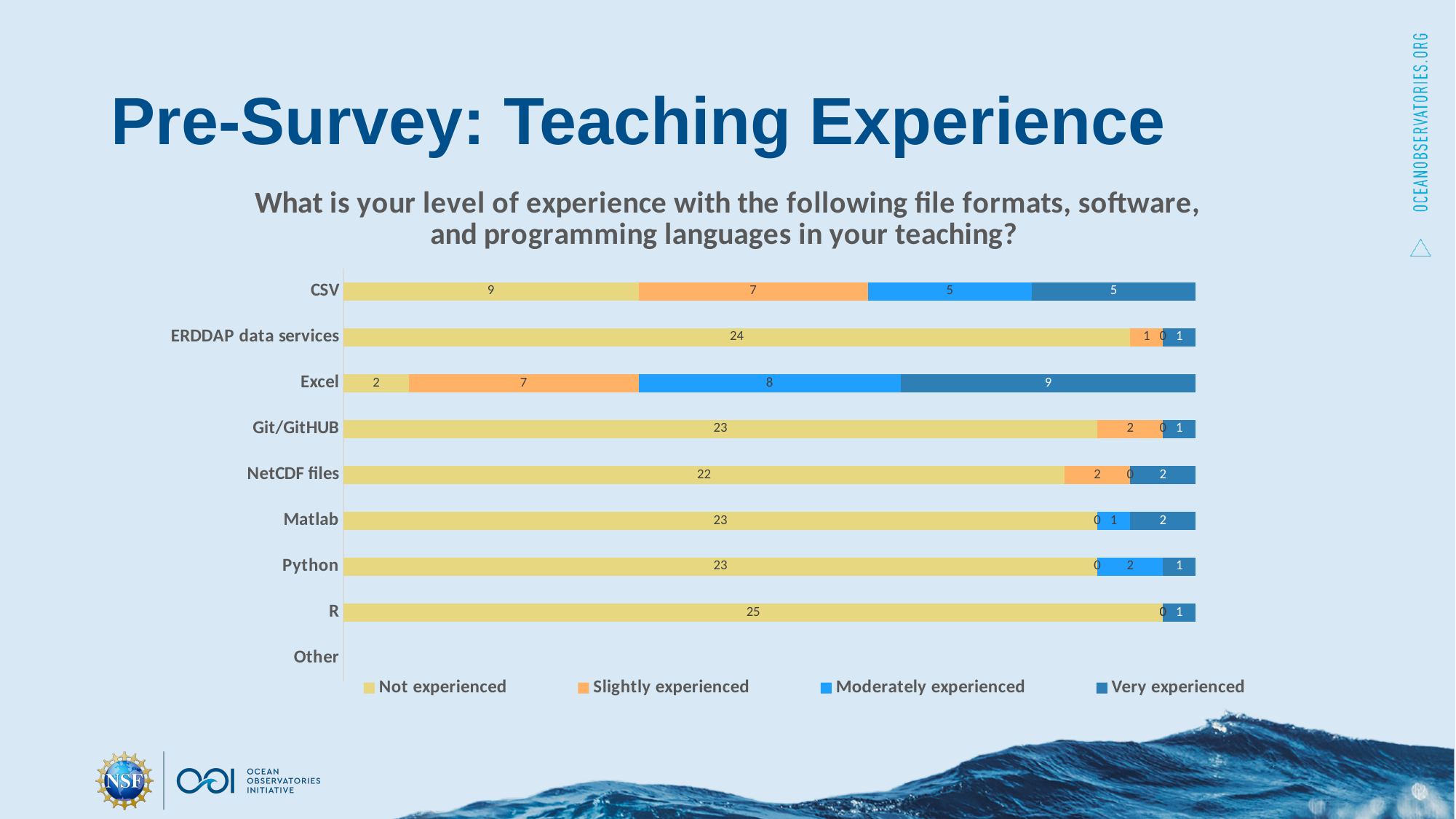
How many series does the legend list? 4 What type of chart is shown on the slide? stacked bar chart Which has more 'Very experienced' responses, CSV or Python? CSV What is the difference between the 'Not experienced' counts for R and Excel? 23 What is the total number of responses in the CSV bar? 26 Which category has the lowest 'Not experienced' count? Excel Which category has the highest 'Not experienced' count? R How many 'Slightly experienced' responses are there for NetCDF files? 2 How many 'Moderately experienced' responses are there for CSV? 5 How many 'Not experienced' responses are there for ERDDAP data services? 24 How many 'Very experienced' responses are there for Excel? 9 Which legend entry is shown in orange? Slightly experienced